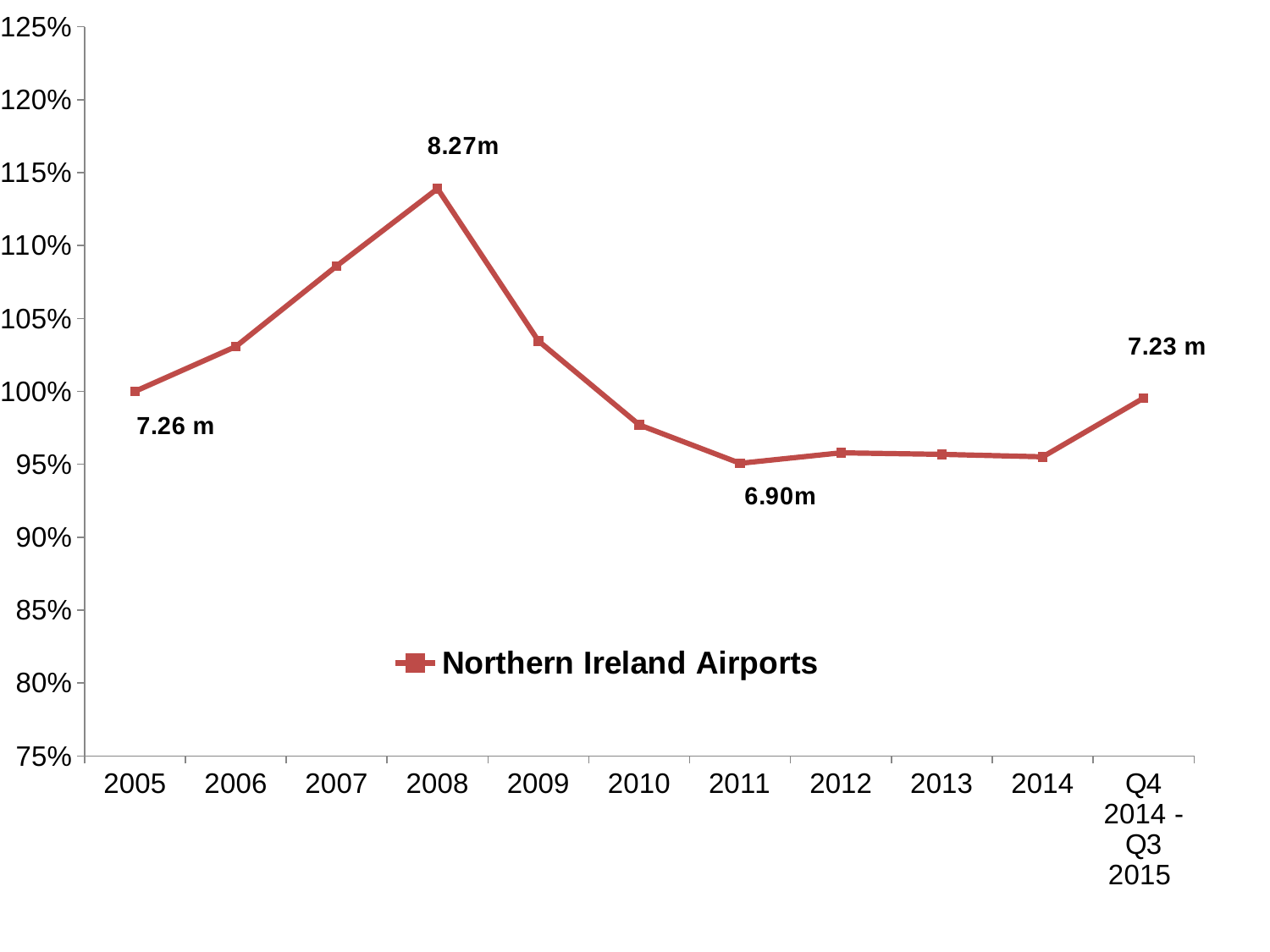
How many data points are plotted along the x axis? 11 What is the name of the series shown in the legend? Northern Ireland Airports What data label is shown at the 2011 point? 6.90m What data label is shown at the Q4 2014 - Q3 2015 point? 7.23 m What kind of chart is shown on the slide? line chart In which year does the Northern Ireland Airports line reach its lowest point? 2011 Is the value for 2007 greater or less than 105%? greater What data label is shown at the 2008 point? 8.27m In which year does the Northern Ireland Airports line reach its highest point? 2008 What data label is shown at the 2005 point? 7.26 m How many series does the legend list? 1 Does the line rise or fall between 2008 and 2011? fall